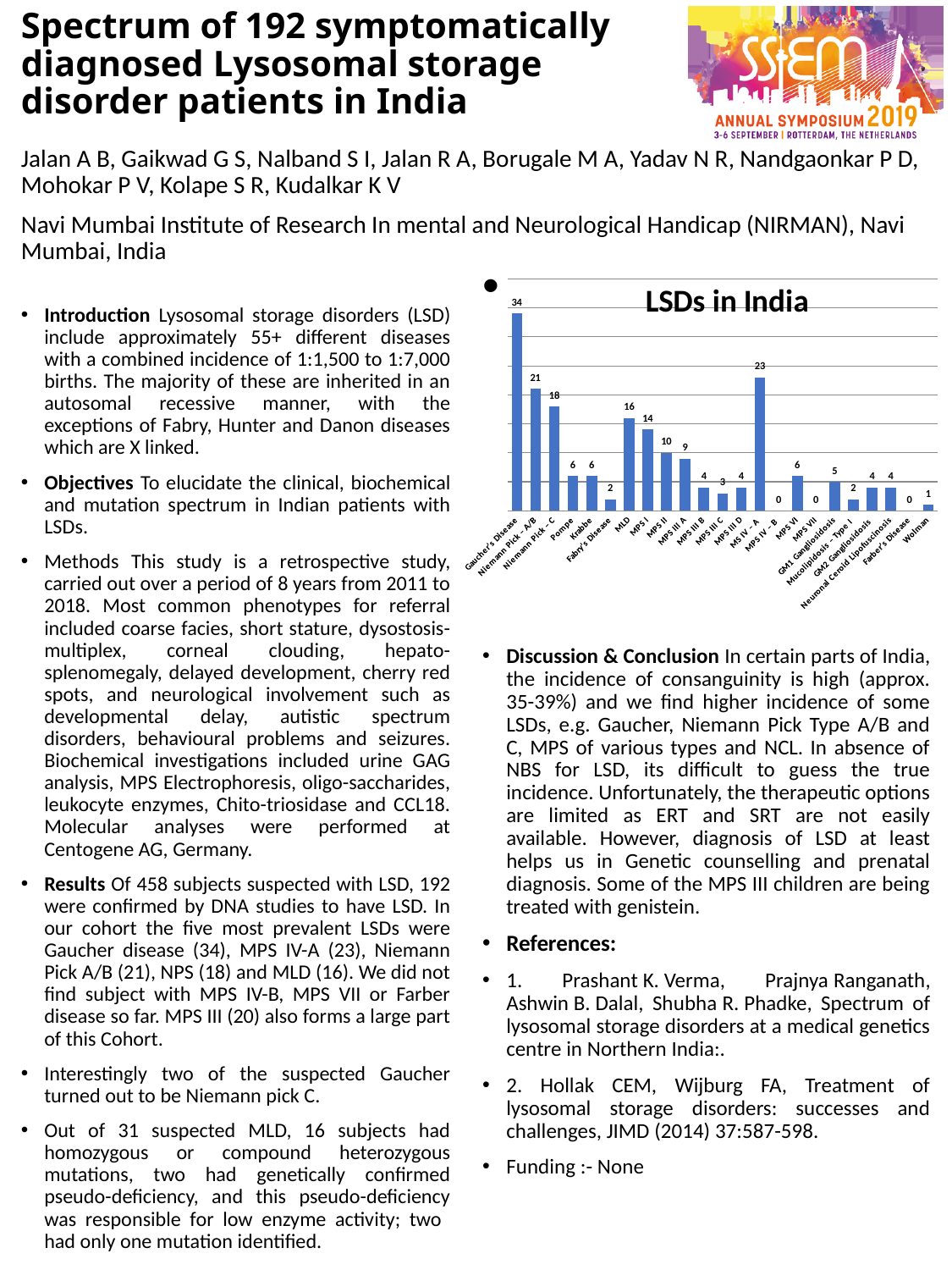
What is the value for Wolman in the chart? 1 What is the difference between the values for Gaucher's Disease and MS IV - A? 11 What is the value for MLD in the chart? 16 What kind of chart is shown on the slide? bar chart What is the value for GM1 Gangliosidosis in the chart? 5 What is the value for MPS I in the chart? 14 How many categories are plotted in the chart? 23 What is the value for Gaucher's Disease in the chart? 34 Which category has the highest value in the chart? Gaucher's Disease What is the title of the chart? LSDs in India Which is larger, the value for MPS II or the value for MPS III A? MPS II What is the difference between the values for Niemann Pick - A/B and Niemann Pick - C? 3